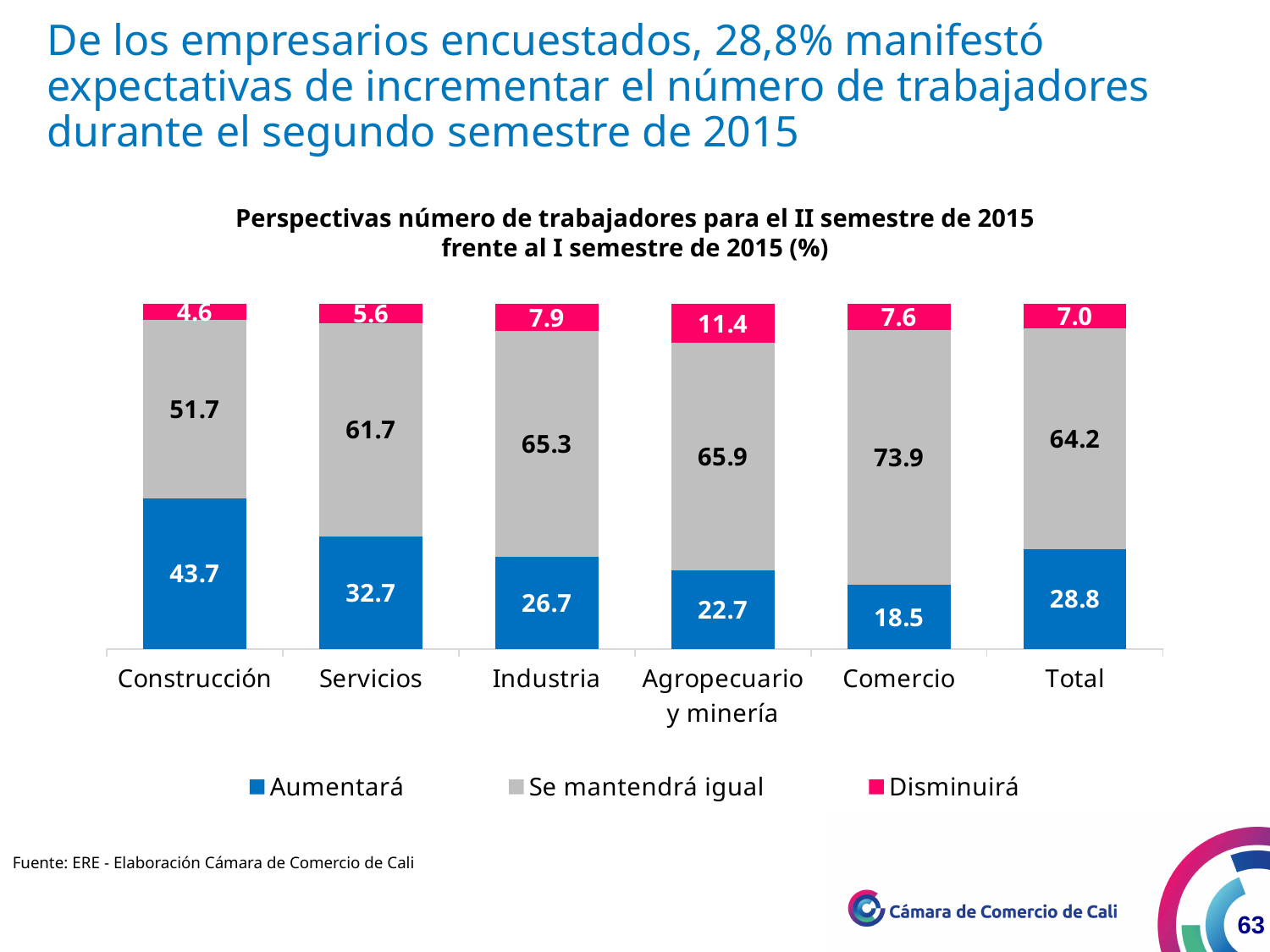
What is the difference between the 'Aumentará' values for Construcción and Servicios? 11.0 How many series does the legend list? 3 Which is larger: the 'Se mantendrá igual' value for Industria or for Servicios? Industria What is the value of 'Disminuirá' for Agropecuario y minería? 11.4 Which category has the lowest 'Aumentará' value? Comercio How many categories are shown on the x axis? 6 What is the value of 'Aumentará' for Construcción? 43.7 Which category has the highest 'Aumentará' value? Construcción What is the value of 'Se mantendrá igual' for Comercio? 73.9 What is the total of the stacked bar for Total? 100.0 What kind of chart is shown on the slide? Stacked bar chart Which category has the highest 'Disminuirá' value? Agropecuario y minería